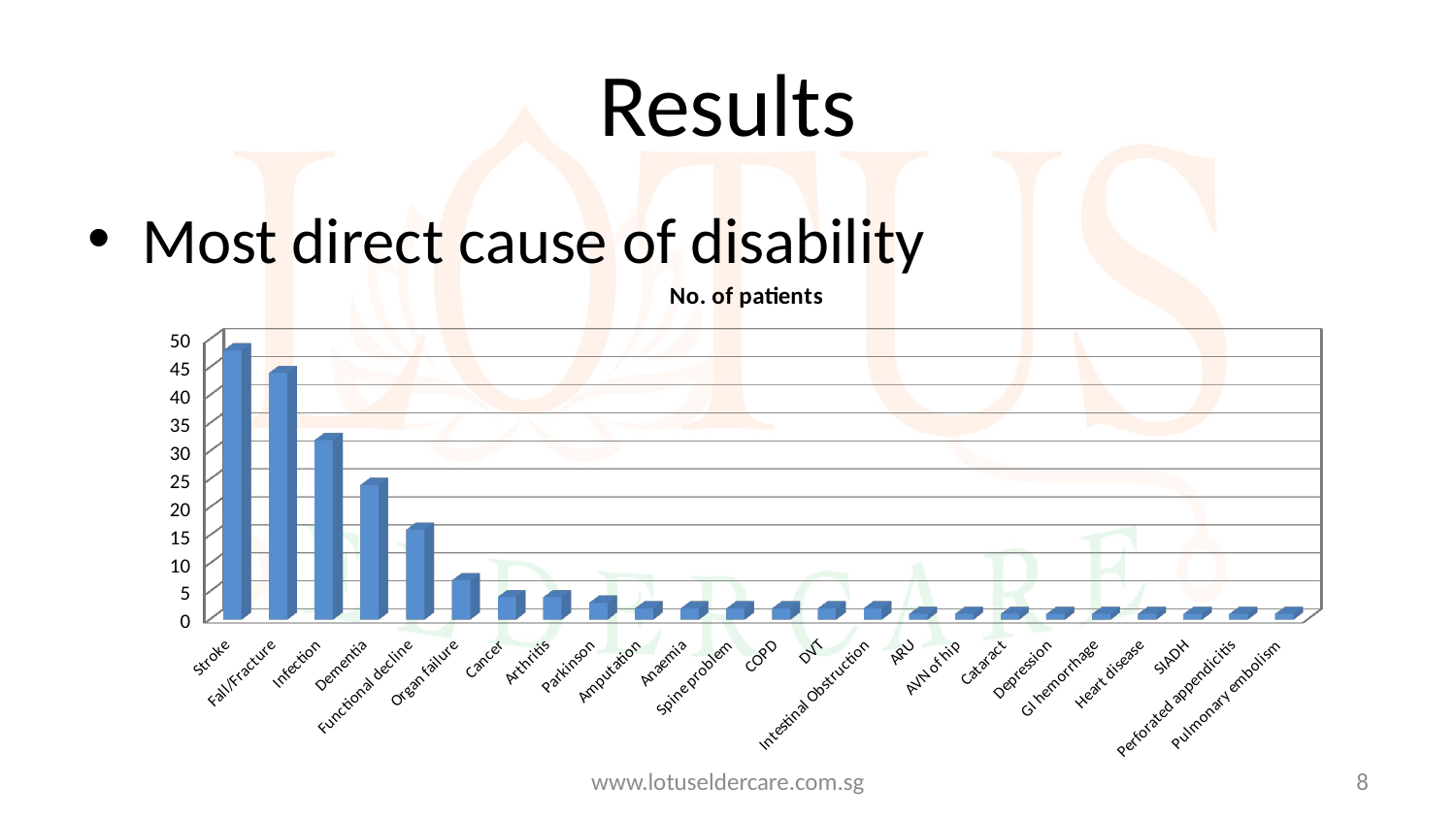
Is the value for Organ failure greater or less than 10? less Which category has the highest number of patients? Stroke Which has more patients, Infection or Dementia? Infection Is the value for Fall/Fracture greater or less than 40? greater Is the value for Stroke greater or less than 45? greater Do the values generally rise or fall moving from left to right along the x axis? fall How many categories are shown on the x axis of the chart? 24 What type of chart is shown on the slide? Bar chart What is the title of the chart? No. of patients